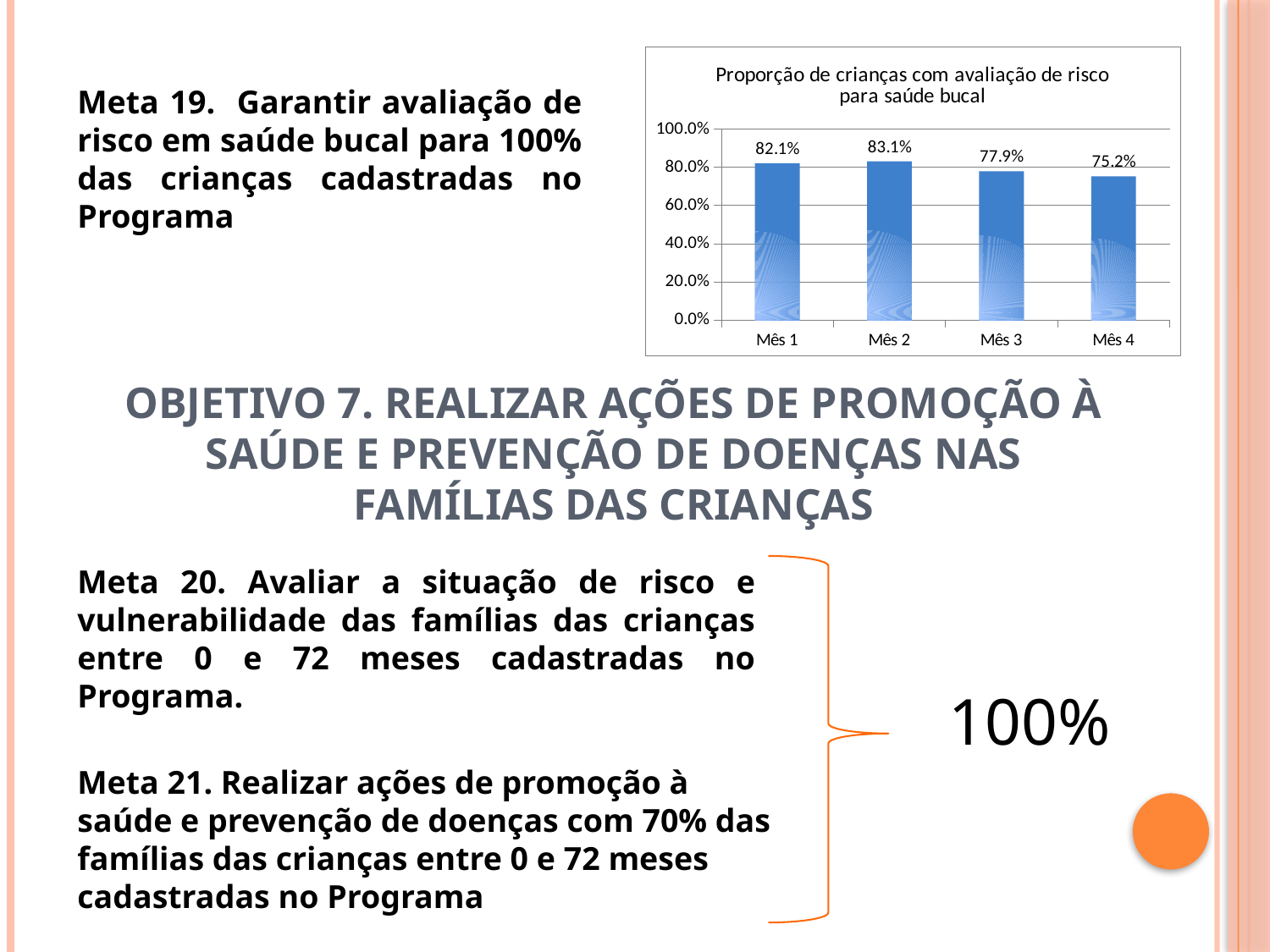
What kind of chart is shown? bar chart What is the difference between the values for Mês 2 and Mês 4? 7.9% How many months are shown on the x axis? 4 What is the value for Mês 4? 75.2% Which month has the highest value? Mês 2 Is the value for Mês 3 greater or less than 80.0%? less Which month has the lowest value? Mês 4 What is the title of the chart? Proporção de crianças com avaliação de risco para saúde bucal What is the value for Mês 1? 82.1% Which is larger, the value for Mês 1 or the value for Mês 3? Mês 1 What is the difference between the values for Mês 1 and Mês 2? 1.0% Do the values rise or fall from Mês 2 to Mês 4? fall